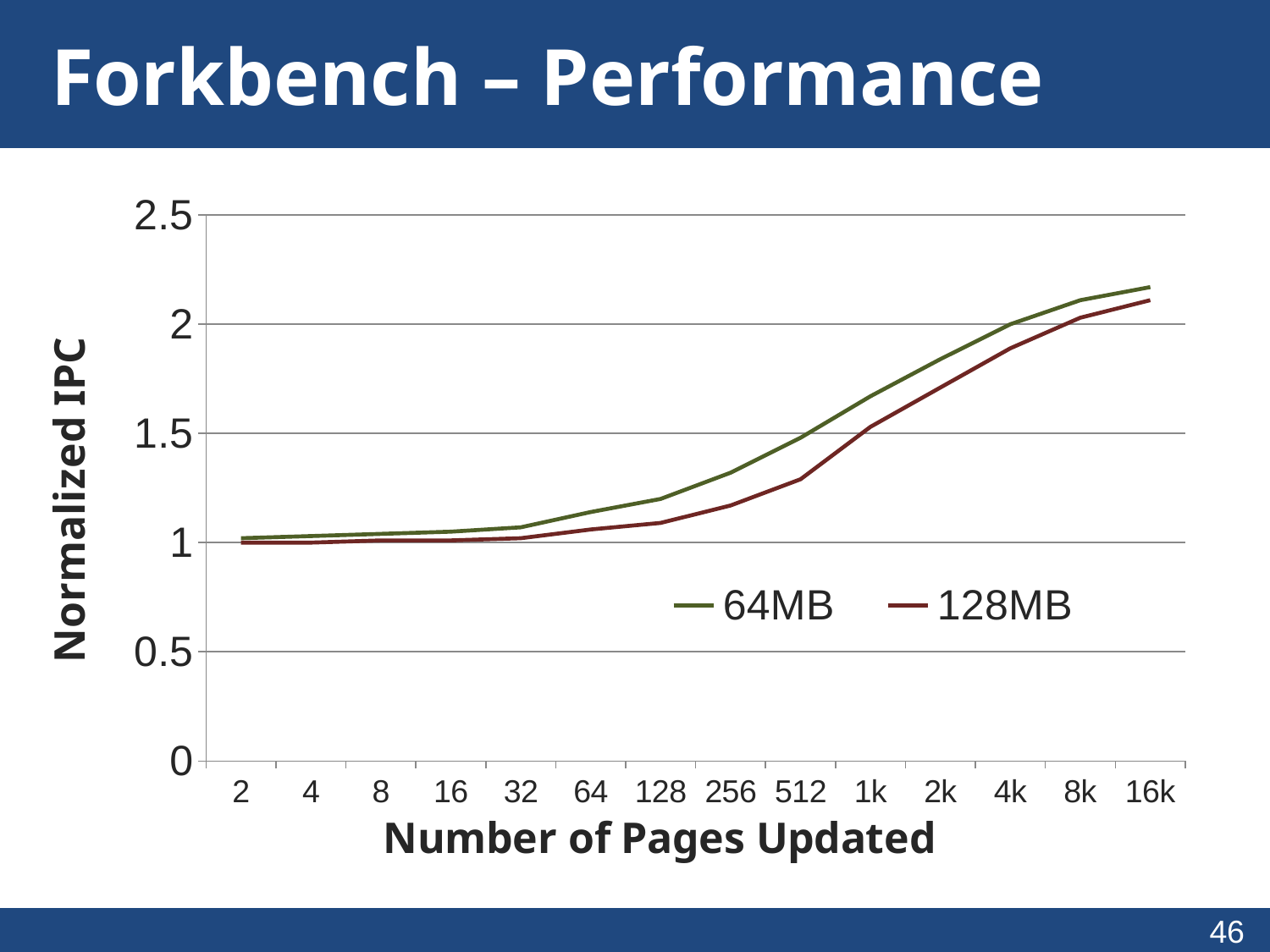
How many series does the legend list? 2 What kind of chart is shown on the slide? line chart Is the 64MB value at 2 pages greater or less than 1.5? less How many points are on the x axis (Number of Pages Updated)? 14 Do the Normalized IPC values rise or fall as the number of pages updated increases? rise Is the 128MB value at 16k pages greater or less than 2? greater What is the title of the x axis? Number of Pages Updated What is the title of the y axis? Normalized IPC Is the 64MB value at 16k pages greater or less than 2? greater For the 64MB series, at which number of pages updated is the Normalized IPC highest? 16k At 1k pages updated, which series has the higher Normalized IPC, 64MB or 128MB? 64MB